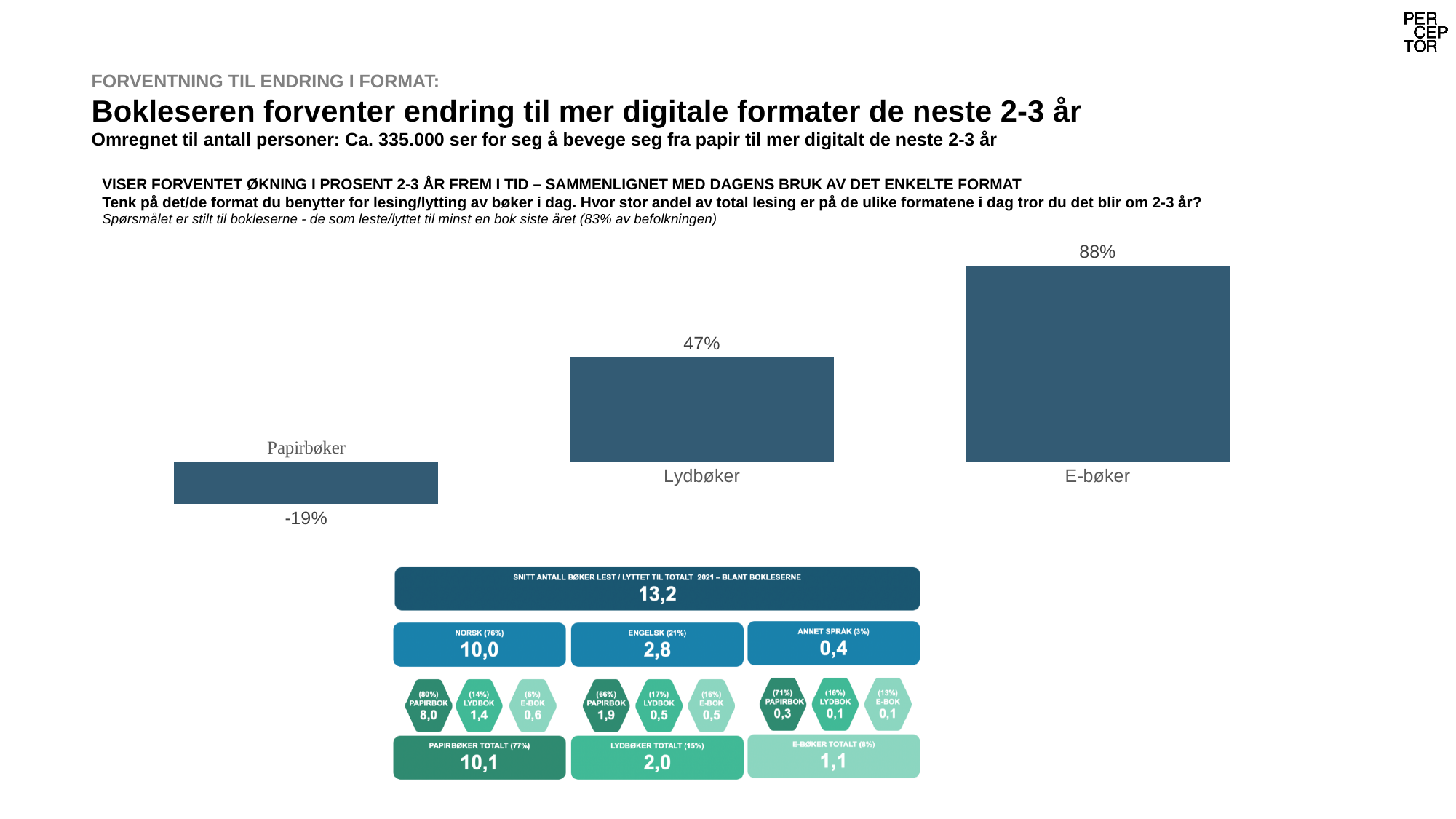
What is the expected change value shown for Papirbøker in the bar chart? -19% Which format in the bar chart has a negative value? Papirbøker Which is larger in the bar chart, the value for Lydbøker or the value for E-bøker? E-bøker What is the expected change value shown for Lydbøker in the bar chart? 47% Which format has the lowest expected change in the bar chart? Papirbøker What is the difference between the values for E-bøker and Lydbøker in the bar chart? 41 percentage points How many formats (categories) are shown in the bar chart? 3 What type of chart is used to show the expected change per format? Bar chart What is the expected change value shown for E-bøker in the bar chart? 88% Which format has the highest expected change in the bar chart? E-bøker What is the difference between the values for Lydbøker and Papirbøker in the bar chart? 66 percentage points Do the values in the bar chart rise or fall from left to right (Papirbøker to E-bøker)? Rise